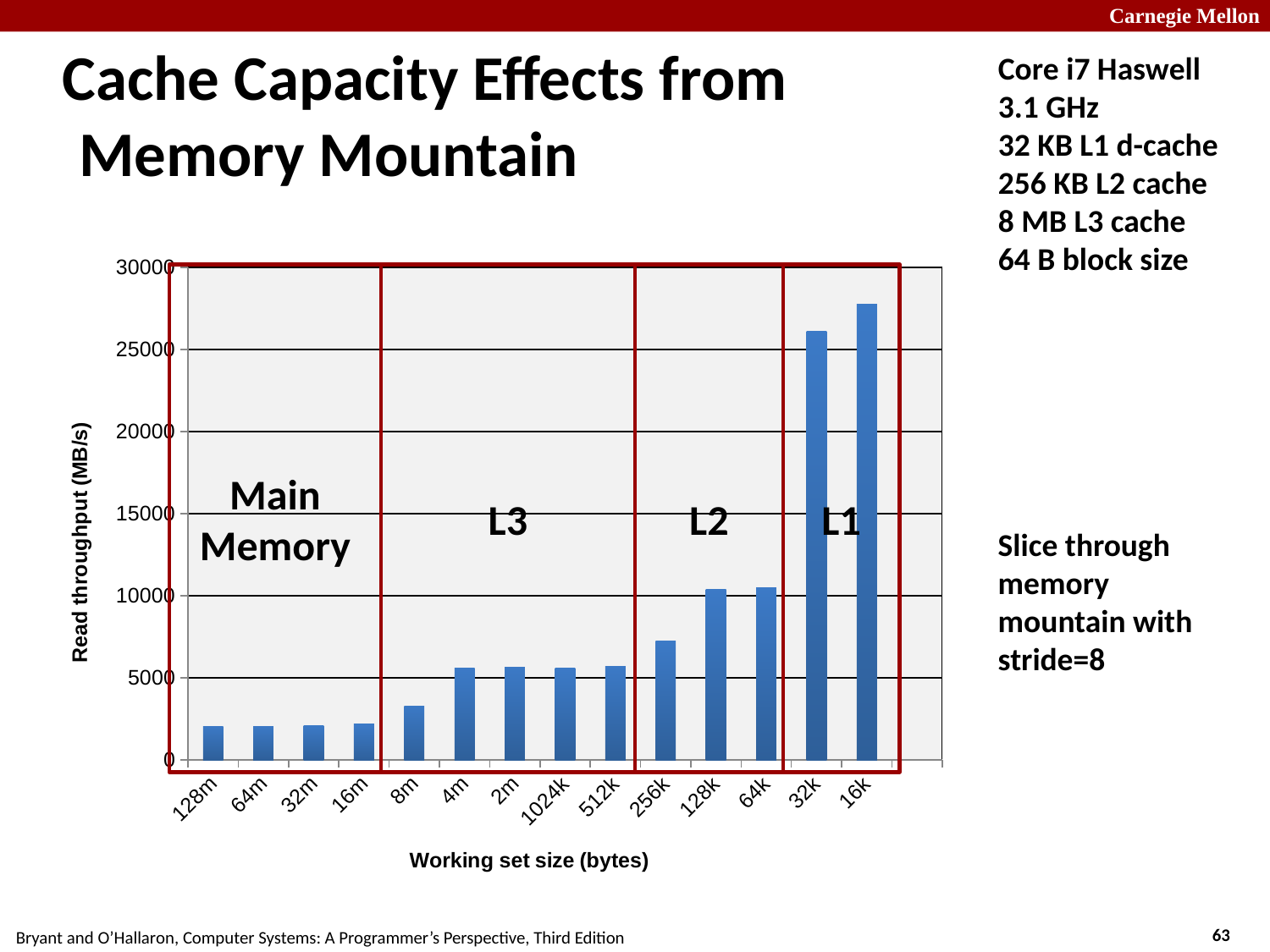
Is the read throughput for 32k greater or less than 20000? greater Is the read throughput for 16k greater or less than 25000? greater Which working set size has the highest read throughput? 16k Do the read throughput values generally rise or fall moving from left to right along the x axis? rise Which has the larger read throughput, 32k or 256k? 32k Is the read throughput for 8m greater or less than 5000? less What is the label of the y axis? Read throughput (MB/s) What kind of chart is shown on the slide? bar chart How many working set sizes are plotted along the x axis? 14 Which has the larger read throughput, 8m or 4m? 4m